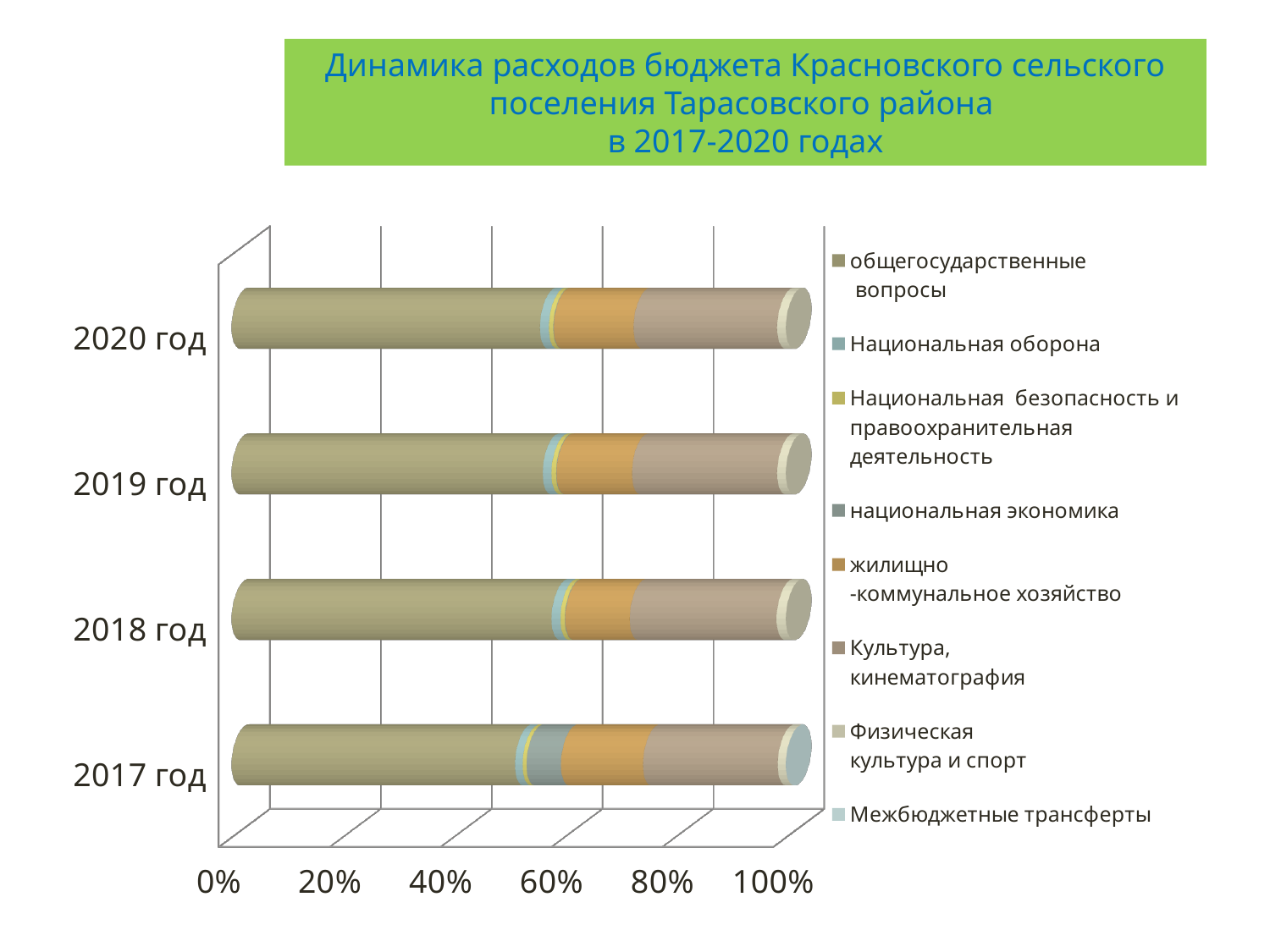
In which year is the национальная экономика segment the largest? 2017 год Which year is shown at the bottom of the chart? 2017 год Is the share of общегосударственные вопросы in 2017 год greater or less than 60%? less How many years (categories) are plotted on the chart? 4 Which legend entry is listed first? общегосударственные вопросы Is the share of общегосударственные вопросы in 2020 год greater or less than 60%? less What is the highest value shown on the horizontal axis? 100% Is the share of Культура, кинематография in 2019 год greater or less than 40%? less What kind of chart is shown on the slide? stacked bar chart How many series does the legend list? 8 What is the title of the chart? Динамика расходов бюджета Красновского сельского поселения Тарасовского района в 2017-2020 годах